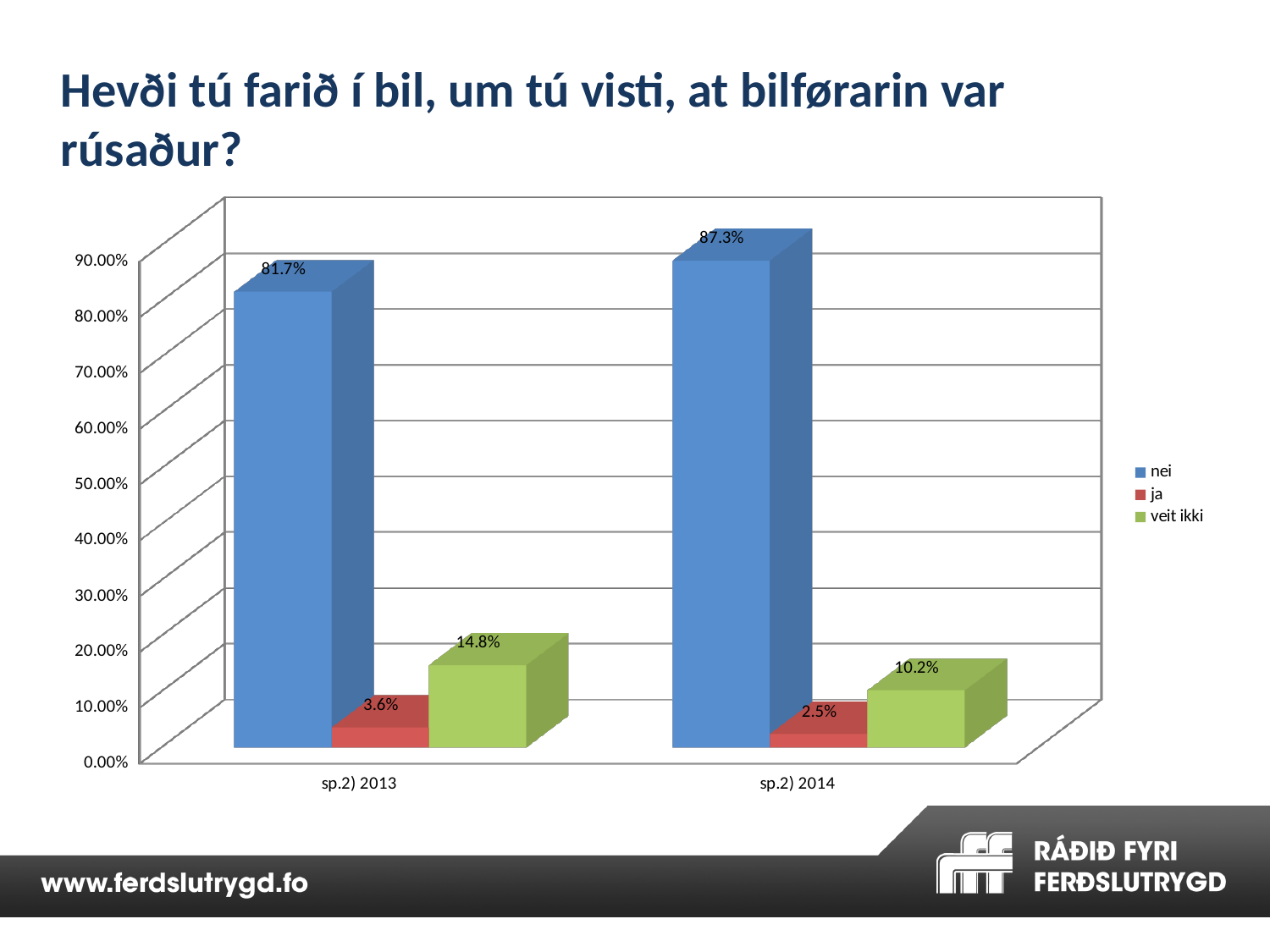
What is the value for "veit ikki" in sp.2) 2014? 10.2% What kind of chart is shown on the slide? bar chart Which series has the highest value in sp.2) 2014? nei How many categories are shown on the x axis? 2 Which is larger: "veit ikki" in sp.2) 2013 or "veit ikki" in sp.2) 2014? sp.2) 2013 Which colour represents the "ja" series in the legend? red What is the value for "nei" in sp.2) 2014? 87.3% What is the difference between the "nei" values for sp.2) 2014 and sp.2) 2013? 5.6% What is the value for "nei" in sp.2) 2013? 81.7% Which series has the lowest value in sp.2) 2013? ja What is the value for "ja" in sp.2) 2013? 3.6% How many series does the legend list? 3